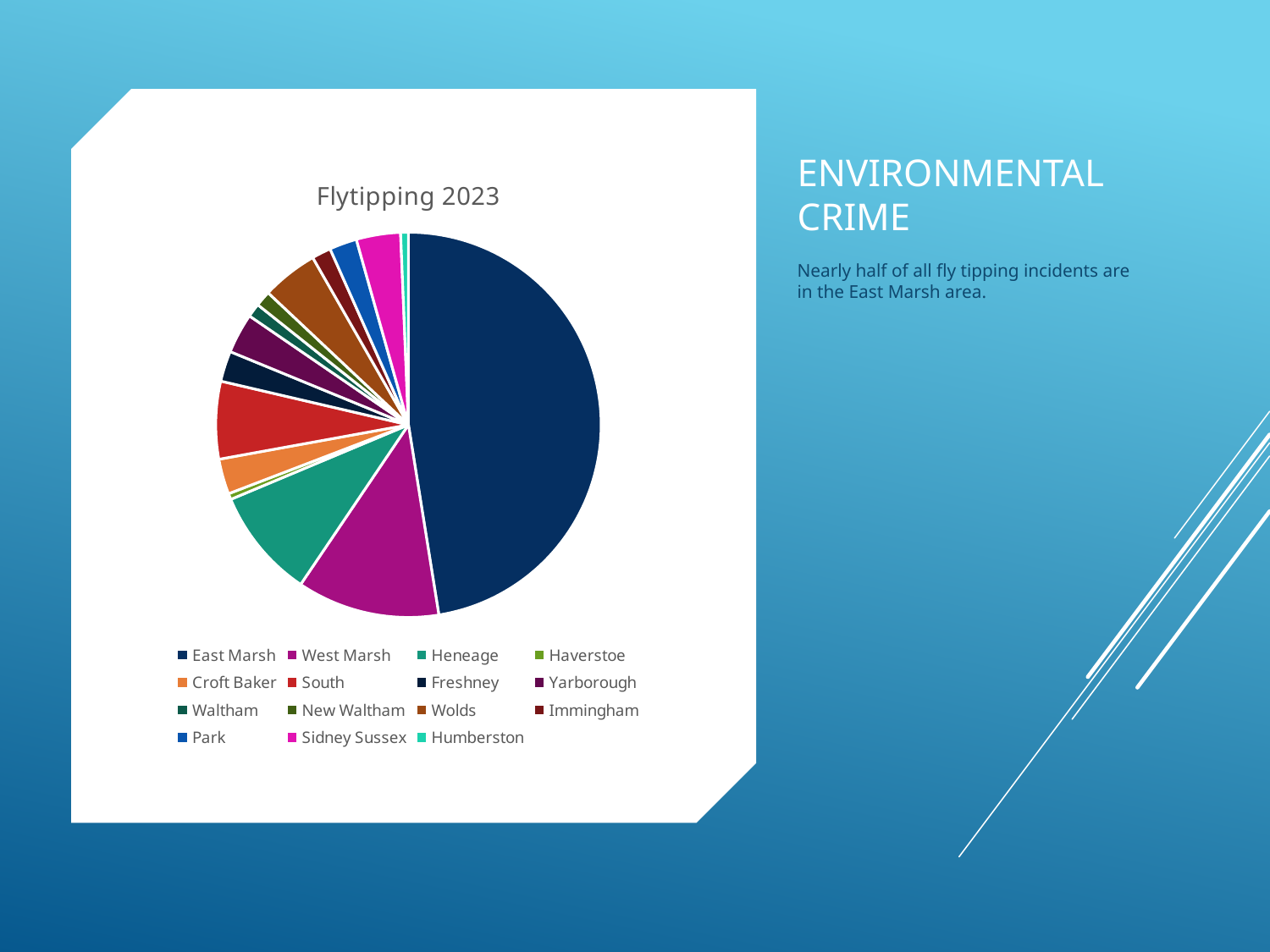
Which slice is larger, Yarborough or New Waltham? Yarborough How many categories does the pie chart's legend list? 15 Which slice is larger, South or Croft Baker? South Which slice is larger, Heneage or Haverstoe? Heneage What kind of chart is shown on the slide? Pie chart What is the title of the chart? Flytipping 2023 Which category has the largest slice of the pie? East Marsh Which category is the first entry listed in the legend? East Marsh